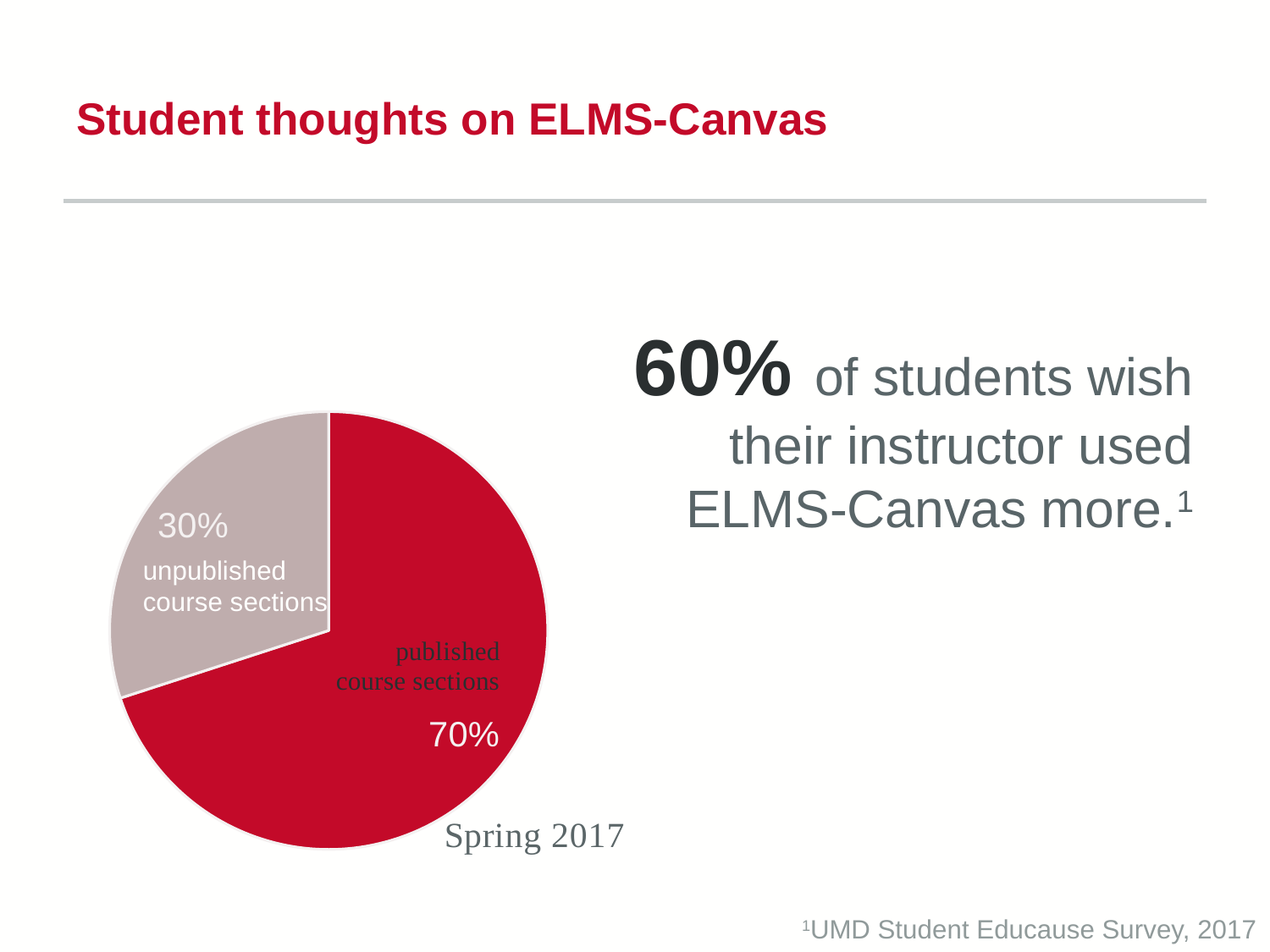
What percentage of course sections were unpublished? 30% Which slice of the pie chart is the smallest? unpublished course sections Which is larger, the share of published course sections or unpublished course sections? published course sections What is the difference in percentage points between published and unpublished course sections? 40 What kind of chart is shown on the slide? pie chart What percentage of course sections were published? 70% What colour is the published course sections slice? red How many slices does the pie chart have? 2 What time period is labelled below the pie chart? Spring 2017 Which slice of the pie chart is the largest? published course sections What share of the pie does the unpublished course sections slice represent? 30%